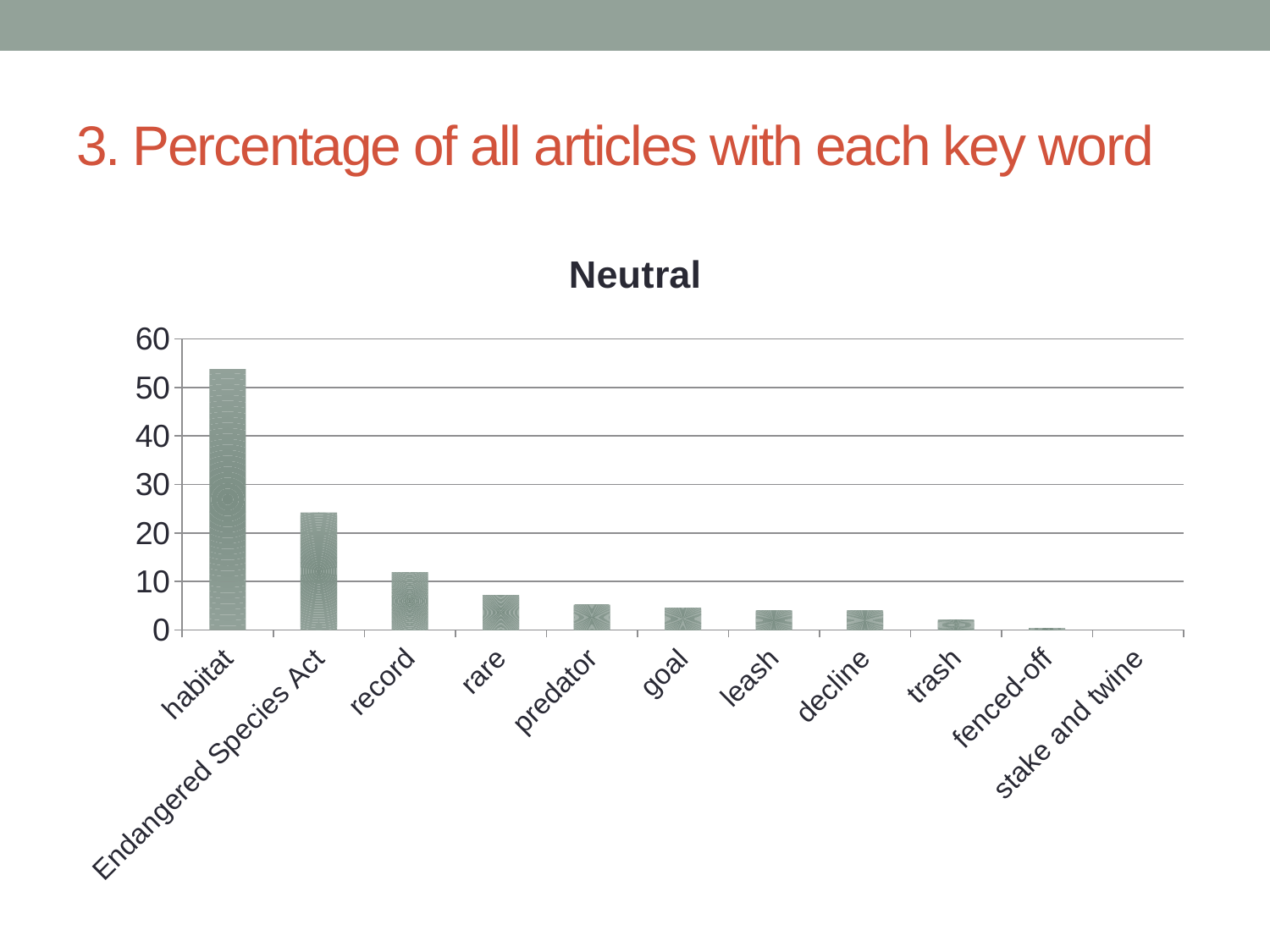
Is the value for Endangered Species Act greater or less than 30? less Which key word has the highest percentage in the chart? habitat Which has a higher value, record or trash? record Which has a higher value, habitat or Endangered Species Act? habitat Is the value for record greater or less than 10? greater What kind of chart is shown on the slide? bar chart What is the title of the chart? Neutral Is the value for habitat greater or less than 50? greater How many key words are plotted on the x axis of the chart? 11 Do the values rise or fall moving from left to right along the x axis? fall Which key word has the lowest percentage in the chart? stake and twine